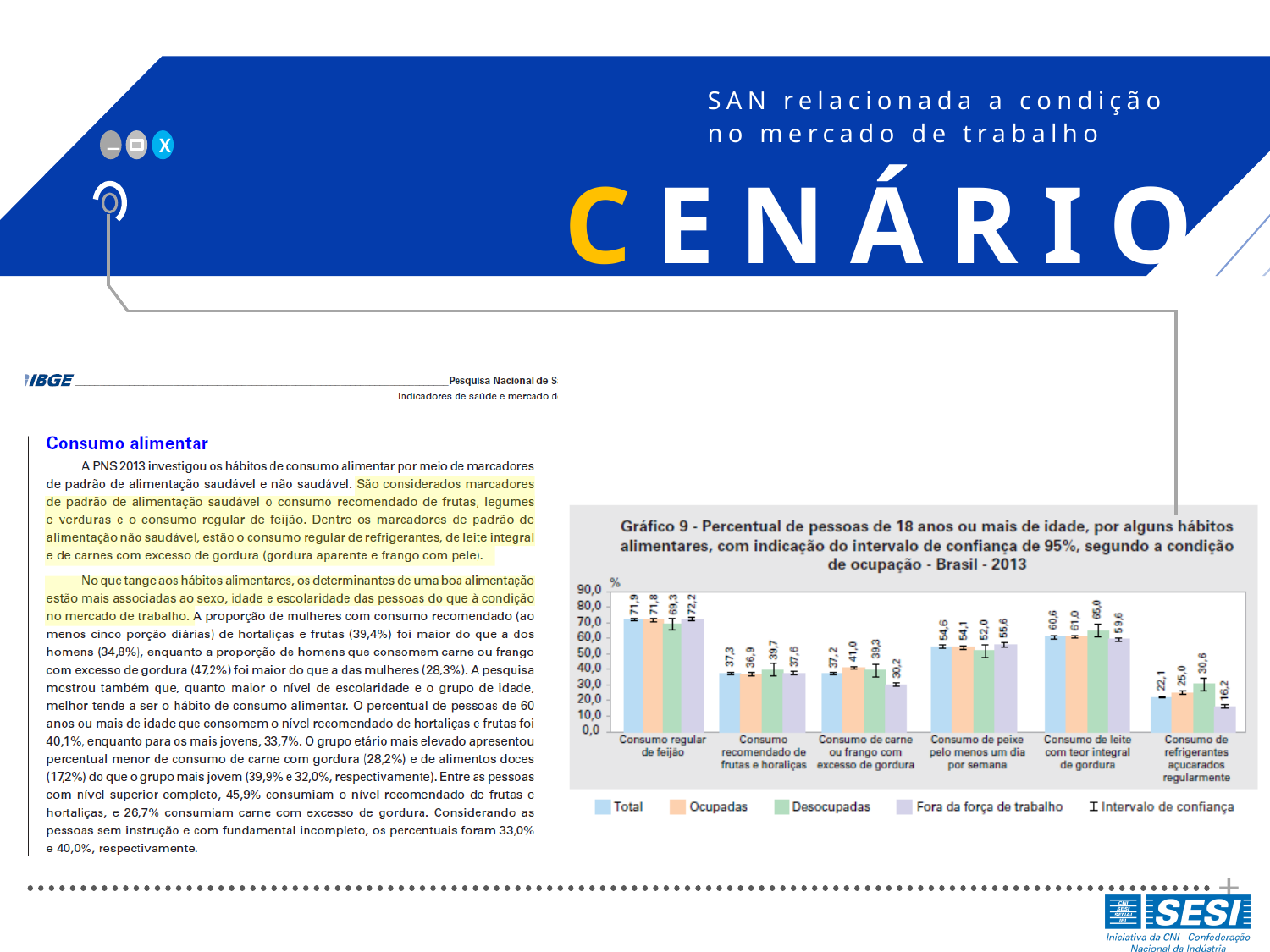
In Gráfico 9, what is the value for 'Desocupadas' in 'Consumo de leite com teor integral de gordura'? 65,0 In Gráfico 9, which food habit category has the highest Total value? Consumo regular de feijão What type of chart is Gráfico 9 on the slide? Bar chart In Gráfico 9, for 'Consumo de refrigerantes açucarados regularmente', which is larger: the value for 'Desocupadas' or for 'Ocupadas'? Desocupadas In Gráfico 9, what is the value for 'Ocupadas' in 'Consumo de carne ou frango com excesso de gordura'? 41,0 In Gráfico 9, how many food habit categories are shown on the x axis? 6 In Gráfico 9, which food habit category has the lowest Total value? Consumo de refrigerantes açucarados regularmente In Gráfico 9, what is the difference between the 'Ocupadas' and 'Fora da força de trabalho' values for 'Consumo de carne ou frango com excesso de gordura'? 10,8 In Gráfico 9, what is the value for 'Fora da força de trabalho' in 'Consumo de refrigerantes açucarados regularmente'? 16,2 In Gráfico 9, what does the 'I' symbol in the legend represent? Intervalo de confiança In Gráfico 9, how many occupation-condition series (bar colours) does the legend list? 4 In Gráfico 9, what is the Total value for 'Consumo regular de feijão'? 71,9